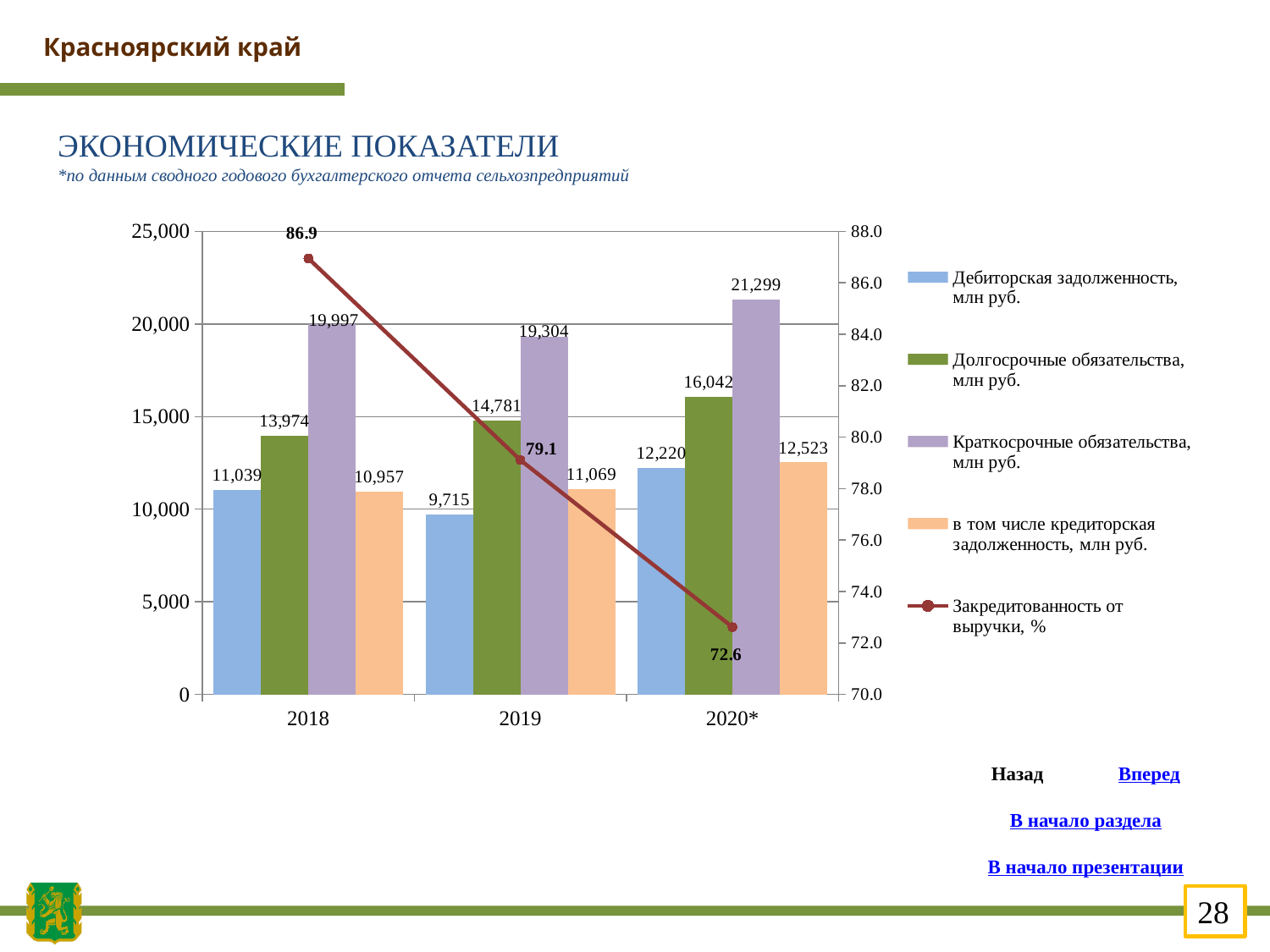
In which year is Дебиторская задолженность, млн руб. lowest? 2019 Which is larger: Долгосрочные обязательства, млн руб. in 2019 or Дебиторская задолженность, млн руб. in 2020*? Долгосрочные обязательства, млн руб. in 2019 What is the value of Дебиторская задолженность, млн руб. for 2019? 9,715 Does Закредитованность от выручки, % rise or fall from 2018 to 2020*? fall In which year is Долгосрочные обязательства, млн руб. highest? 2020* What kind of chart is shown on the slide? Combined bar and line chart What is the value of в том числе кредиторская задолженность, млн руб. for 2020*? 12,523 What is the value of Краткосрочные обязательства, млн руб. for 2020*? 21,299 How many series does the legend list? 5 What is the difference between Краткосрочные обязательства, млн руб. in 2020* and in 2019? 1,995 What is the value of Закредитованность от выручки, % for 2018? 86.9 How many years are shown on the x axis? 3